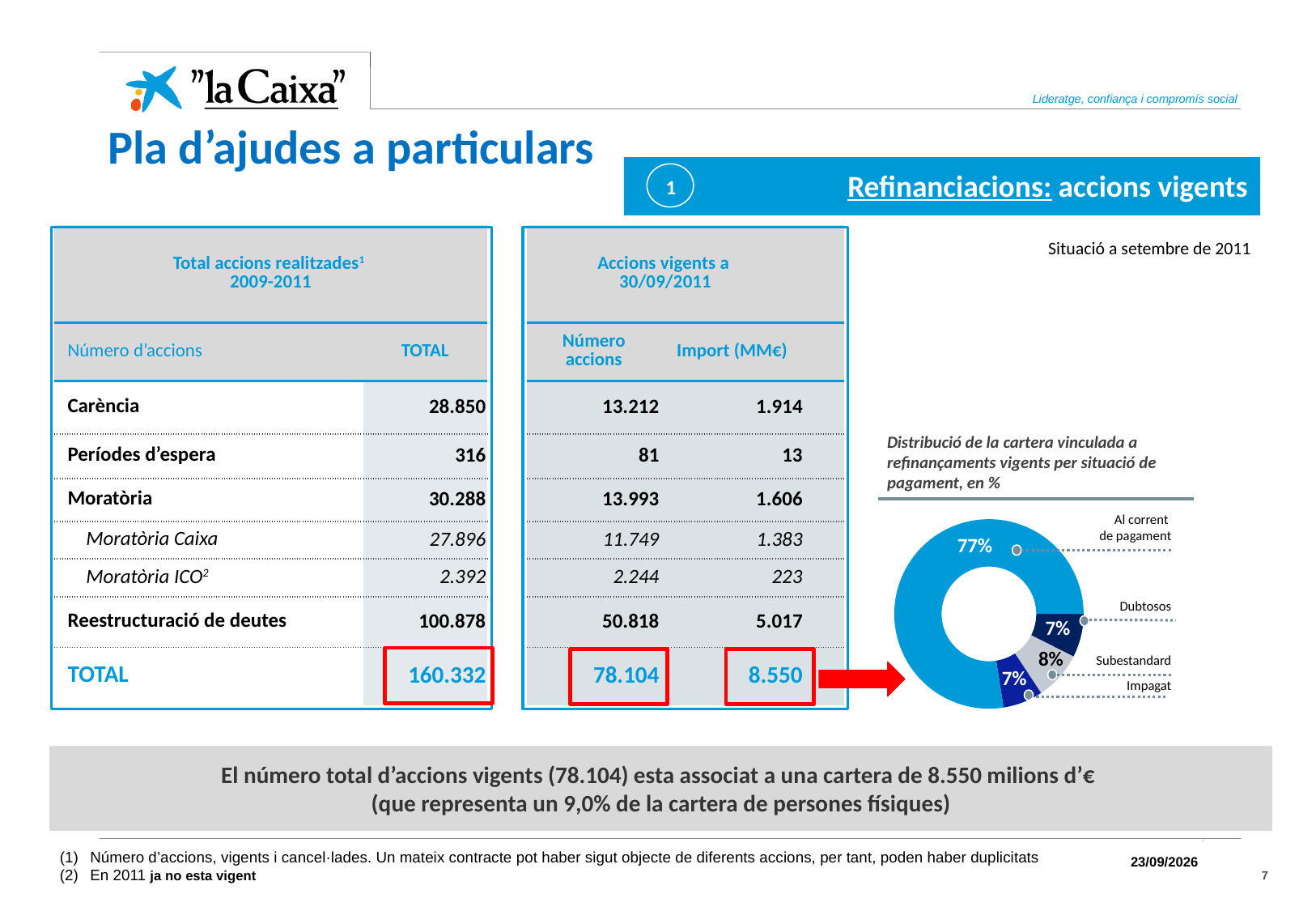
What percentage does the 'Impagat' segment represent in the donut chart? 7% By how many percentage points does 'Al corrent de pagament' exceed 'Dubtosos' in the donut chart? 70 What percentage does the 'Dubtosos' segment represent in the donut chart? 7% How many segments does the donut chart have? 4 Which is larger in the donut chart, 'Al corrent de pagament' or 'Dubtosos'? Al corrent de pagament Which segment is the largest in the donut chart? Al corrent de pagament Is the 'Al corrent de pagament' share in the donut chart greater or less than 50%? greater What kind of chart is shown on the right of the slide? Pie chart (donut) What colour is the 'Al corrent de pagament' segment in the donut chart? Light blue What is the title of the donut chart? Distribució de la cartera vinculada a refinançaments vigents per situació de pagament, en % What percentage of the portfolio is 'Al corrent de pagament' in the donut chart? 77% What percentage does the 'Subestandard' segment represent in the donut chart? 8%